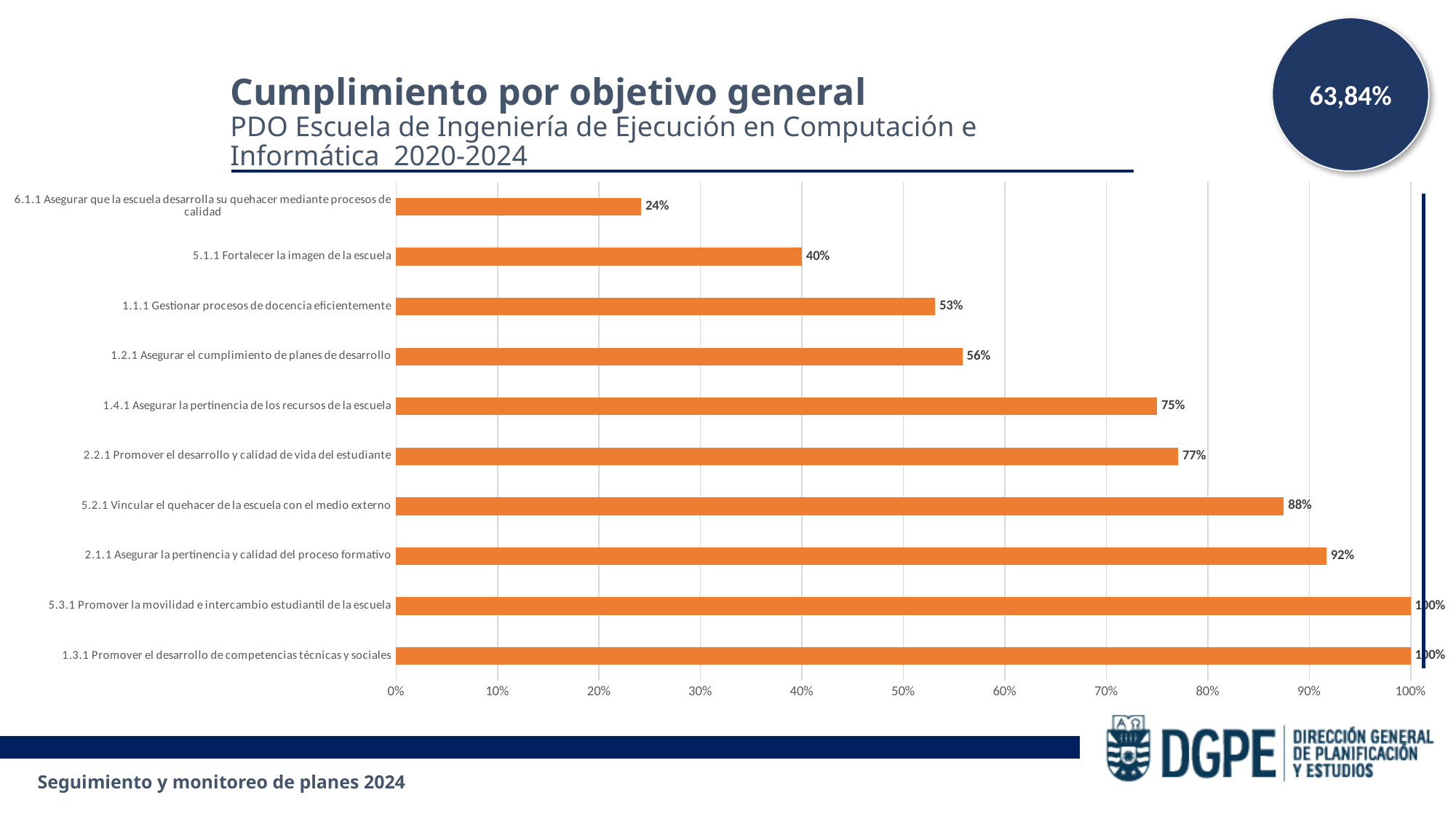
How many objectives are shown in the chart? 10 What overall percentage is shown in the circle at the top right of the slide? 63,84% What is the value for 1.4.1 Asegurar la pertinencia de los recursos de la escuela? 75% What is the value for 2.1.1 Asegurar la pertinencia y calidad del proceso formativo? 92% Which is larger, the value for 1.2.1 Asegurar el cumplimiento de planes de desarrollo or the value for 2.2.1 Promover el desarrollo y calidad de vida del estudiante? 2.2.1 Promover el desarrollo y calidad de vida del estudiante How many objectives have a value of 100%? 2 What is the main title of the chart? Cumplimiento por objetivo general What kind of chart is shown on the slide? bar chart What is the value for 5.1.1 Fortalecer la imagen de la escuela? 40% Which objective has the lowest value? 6.1.1 Asegurar que la escuela desarrolla su quehacer mediante procesos de calidad Is the value for 6.1.1 Asegurar que la escuela desarrolla su quehacer mediante procesos de calidad greater or less than 30%? less What is the difference between the values for 5.2.1 Vincular el quehacer de la escuela con el medio externo and 1.1.1 Gestionar procesos de docencia eficientemente? 35%